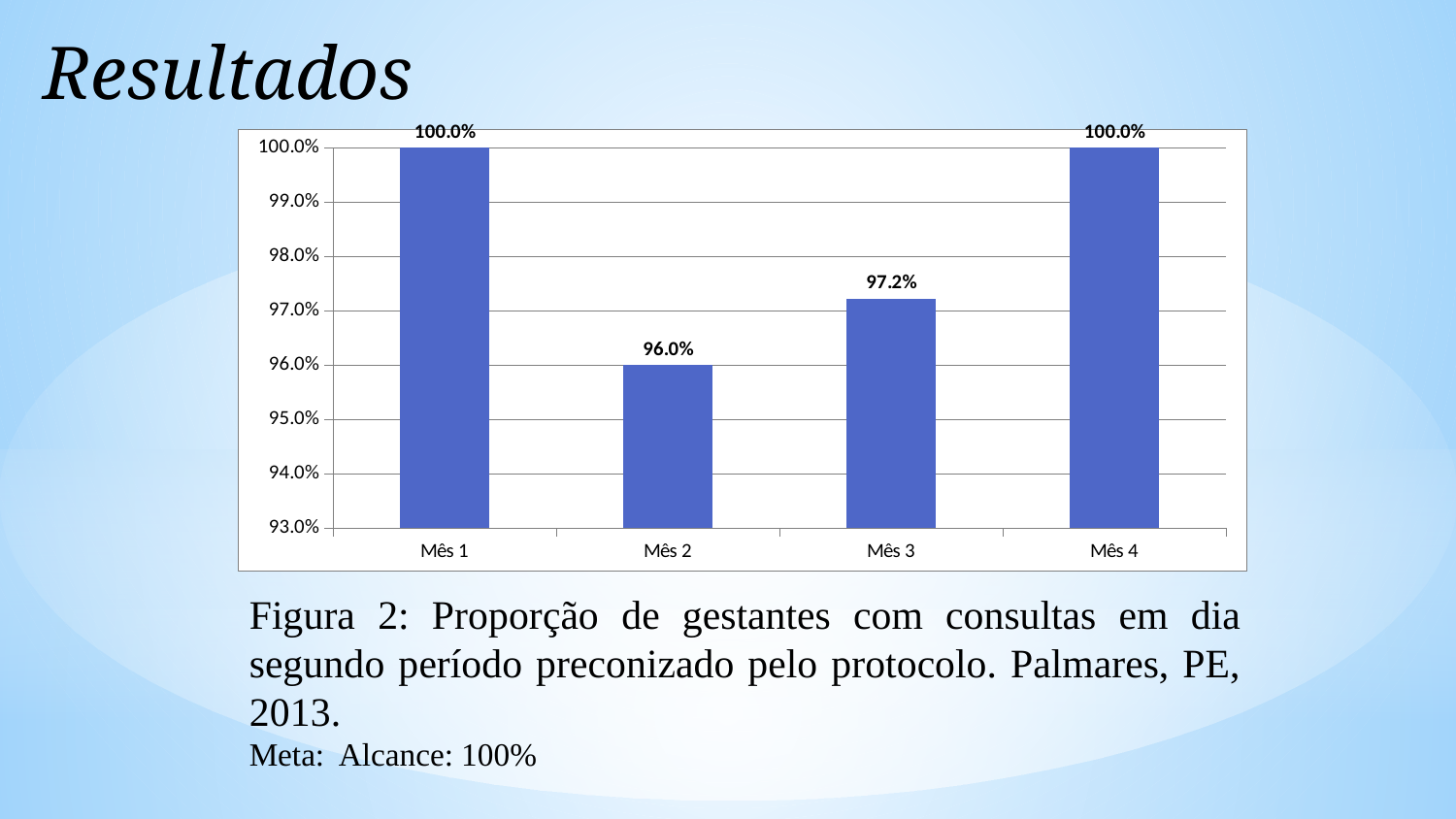
What is the lowest value shown on the y axis? 93.0% Which month has the lowest value? Mês 2 What is the value for Mês 2? 96.0% What kind of chart is shown on the slide? bar chart Which is larger, the value for Mês 2 or the value for Mês 3? Mês 3 What is the difference between the values for Mês 3 and Mês 2? 1.2% What is the difference between the values for Mês 1 and Mês 3? 2.8% What is the value for Mês 1? 100.0% How many categories are shown on the x axis? 4 Do the values rise or fall from Mês 2 to Mês 4? rise Is the value for Mês 3 greater or less than 97.0%? greater What is the value for Mês 3? 97.2%